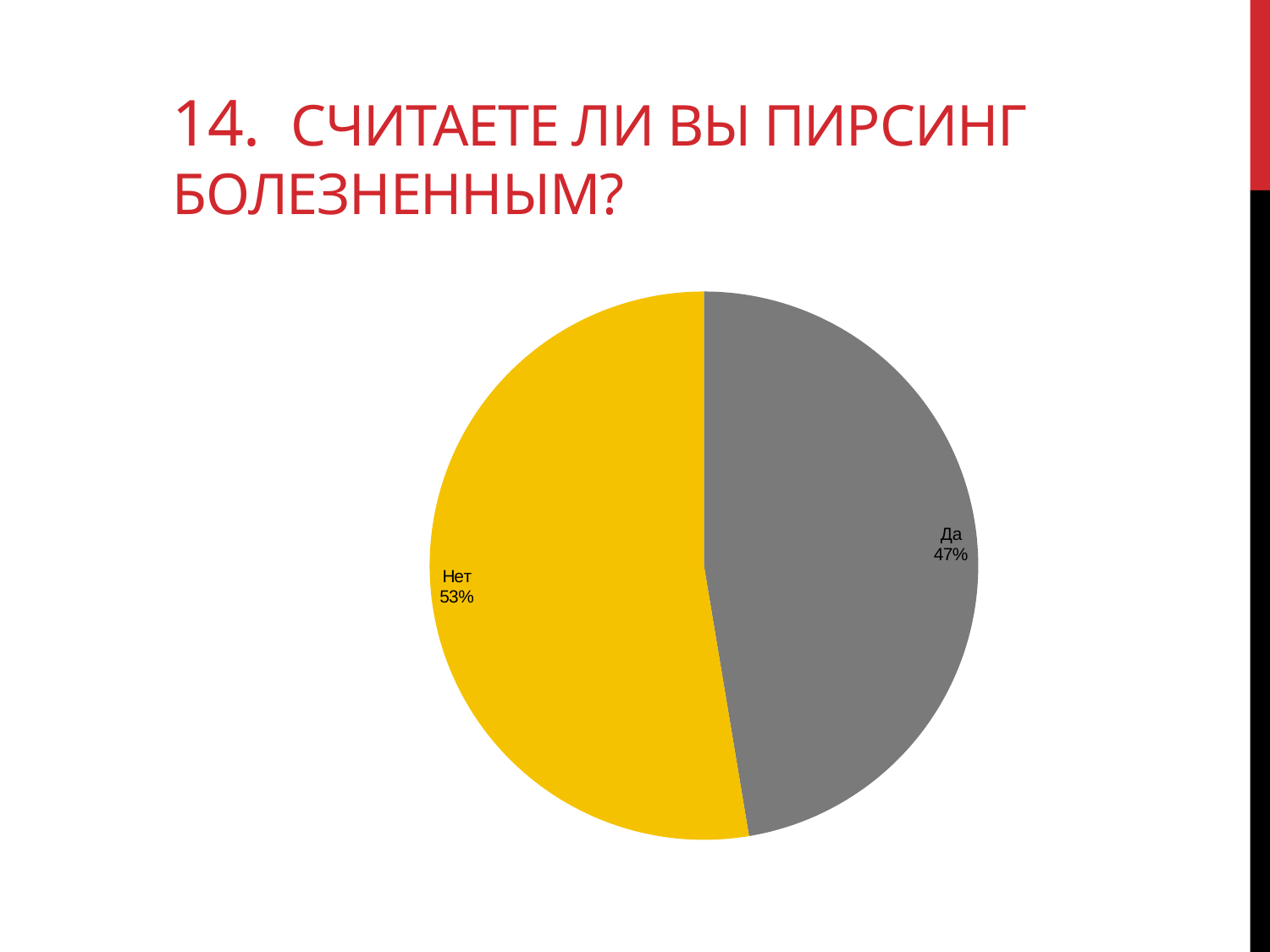
How many slices does the pie chart have? 2 What colour is the "Да" slice? Grey What kind of chart is shown on the slide? Pie chart Which slice is the smallest in the pie chart? Да What colour is the "Нет" slice? Yellow Which slice is larger, "Да" or "Нет"? Нет What share of the pie does the "Нет" slice represent? 53% Which slice is the largest in the pie chart? Нет Is the share for "Да" greater or less than 50%? less What share of the pie does the "Да" slice represent? 47% What is the difference in percentage points between the "Нет" and "Да" slices? 6